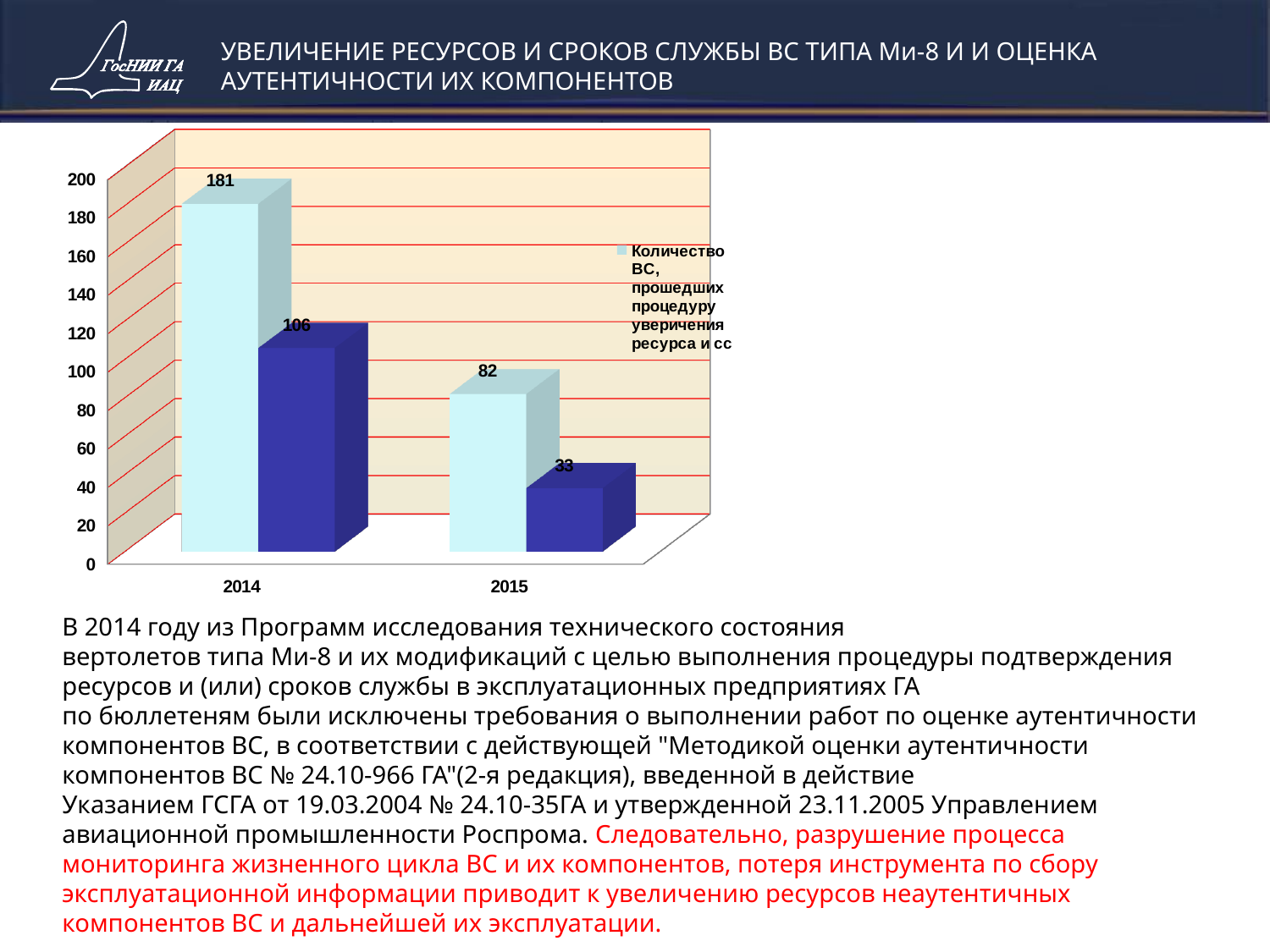
What is the value of the light blue bar (Количество ВС, прошедших процедуру уверичения ресурса и сс) for 2015? 82 Which is larger: the dark blue bar for 2014 or the light blue bar for 2015? The dark blue bar for 2014 (106) Which bar on the chart has the lowest value? The dark blue bar for 2015 (33) Which year has the highest value for the light blue series? 2014 How many years are shown on the x axis of the chart? 2 Do the values rise or fall from 2014 to 2015? fall What is the value of the light blue bar (Количество ВС, прошедших процедуру уверичения ресурса и сс) for 2014? 181 What is the value of the dark blue bar for 2014? 106 What is the value of the dark blue bar for 2015? 33 Is the value of the light blue bar for 2014 greater or less than 160? greater By how much does the light blue series value fall from 2014 to 2015? 99 What is the difference between the light blue and dark blue bars for 2014? 75